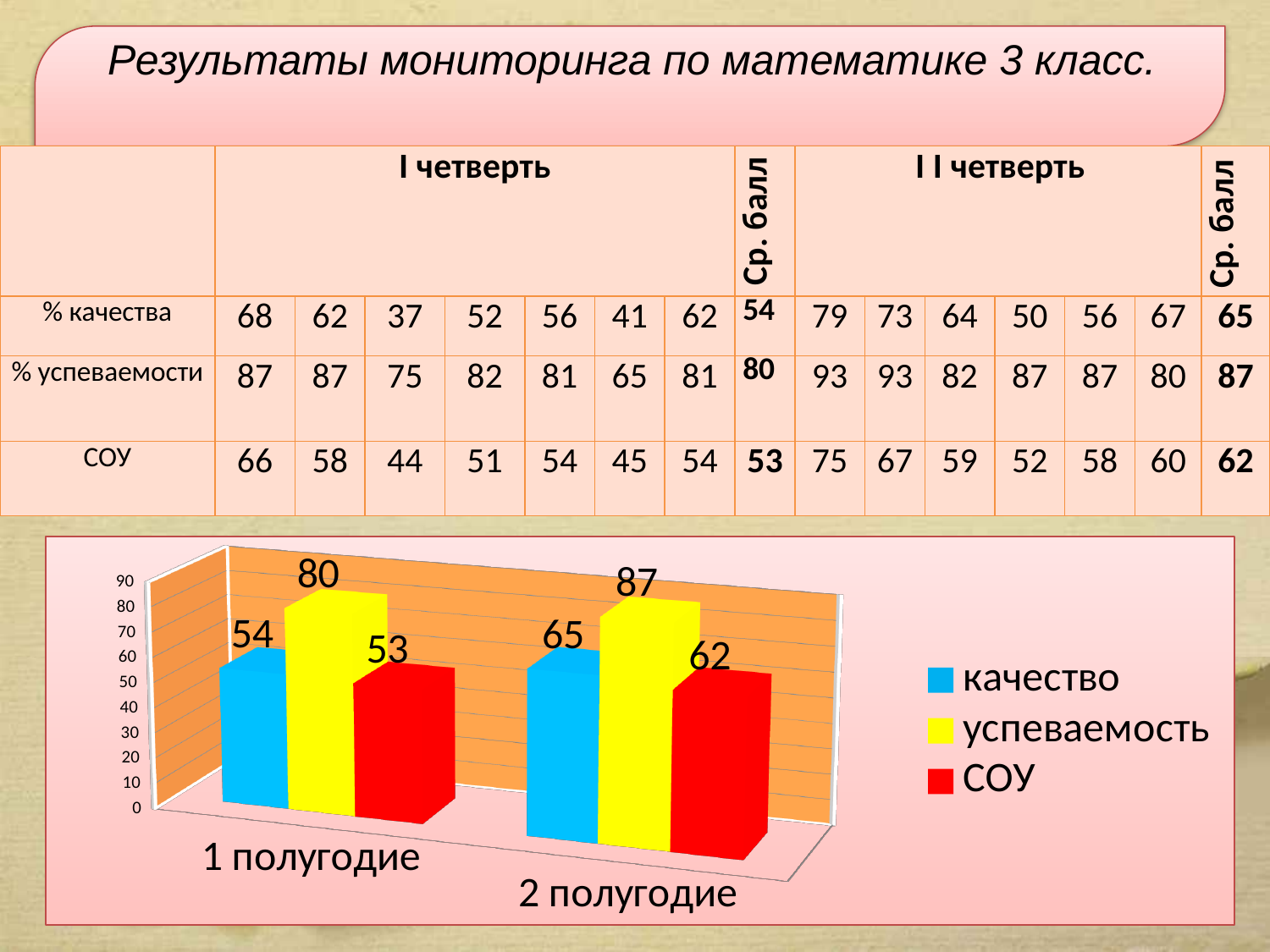
What is the value for качество in 2 полугодие? 65 What is the value for СОУ in 1 полугодие? 53 What is the value for успеваемость in 2 полугодие? 87 What is the value for качество in 1 полугодие? 54 What is the difference between успеваемость in 2 полугодие and успеваемость in 1 полугодие? 7 What kind of chart is shown on the slide? bar chart How many categories are shown on the x axis of the chart? 2 Which is larger: качество in 2 полугодие or СОУ in 2 полугодие? качество in 2 полугодие Which series has the lowest value in 1 полугодие? СОУ How many series does the chart legend list? 3 Which series has the highest value in 2 полугодие? успеваемость Does the value for СОУ rise or fall from 1 полугодие to 2 полугодие? rise